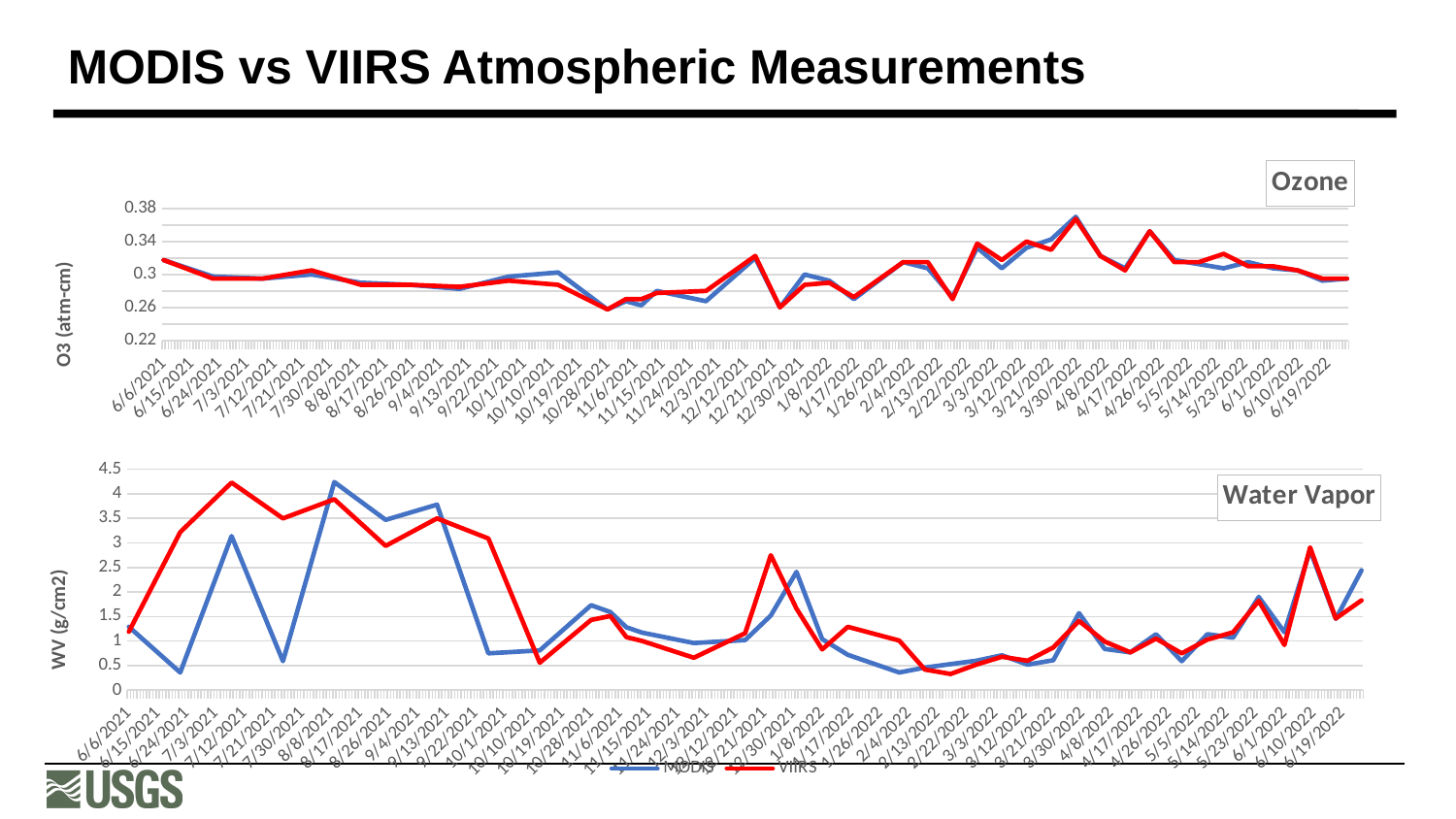
In the Ozone chart, is the VIIRS value on 10/28/2021 greater or less than 0.3? less In the Water Vapor chart, is the highest VIIRS value greater or less than 4? greater How many series does the legend list for the charts? 2 In the Ozone chart, do the values generally rise or fall between 10/28/2021 and 3/30/2022? rise What kind of chart is the Water Vapor chart? line chart In the Water Vapor chart, is the lowest MODIS value greater or less than 1? less What kind of chart is the Ozone chart? line chart In the Ozone chart, which is higher for MODIS: the value on 3/30/2022 or the value on 6/6/2021? 3/30/2022 What is the y-axis label of the Ozone chart? O3 (atm-cm) What is the y-axis label of the Water Vapor chart? WV (g/cm2)